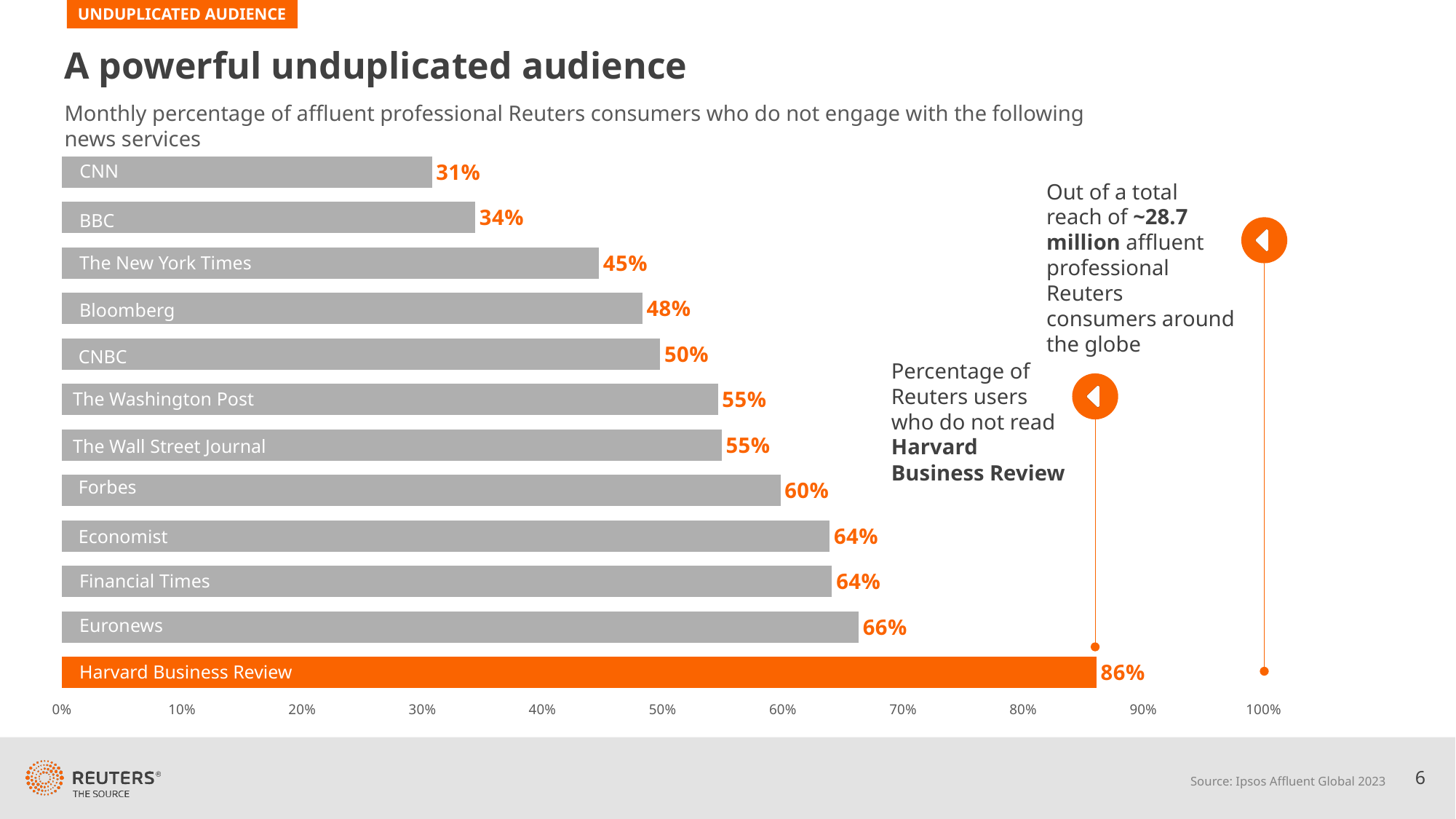
What percentage of affluent professional Reuters consumers do not engage with CNN? 31% What is the value shown for Bloomberg? 48% What is the difference between the values for Harvard Business Review and CNN? 55% How many news services are shown on the chart? 12 Which has a larger value, BBC or CNBC? CNBC Which news service has the lowest value on the chart? CNN Is the value for Economist greater or less than 50%? greater What type of chart is shown on the slide? Bar chart Which bar is highlighted in orange rather than grey? Harvard Business Review What is the difference between the values for Forbes and The New York Times? 15% Which news service has the highest percentage of Reuters consumers who do not engage with it? Harvard Business Review What is the value shown for Euronews? 66%